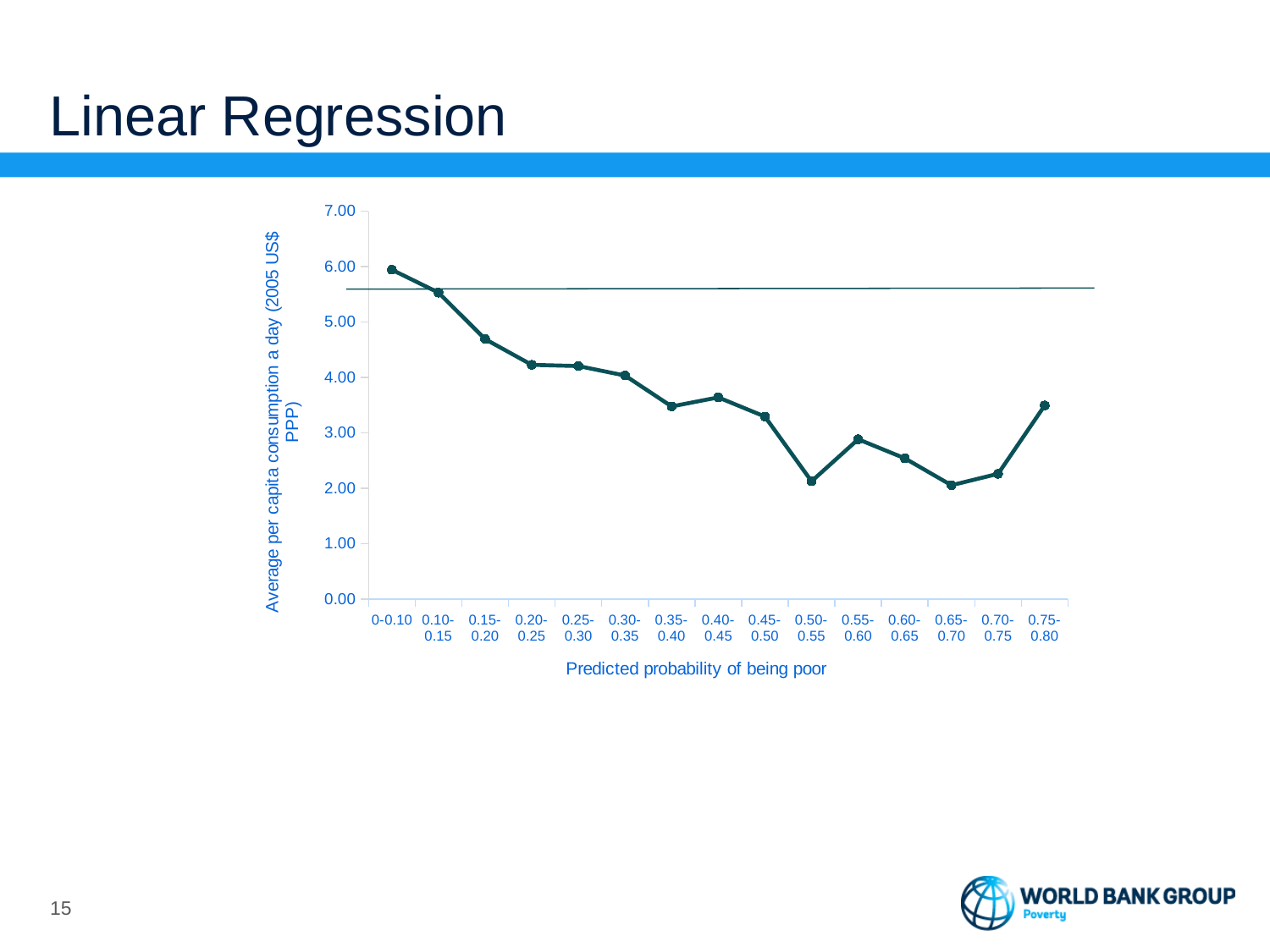
Which predicted probability category has the highest average per capita consumption? 0-0.10 How many predicted probability categories are plotted along the x axis? 15 Is the value for the 0-0.10 category greater or less than 5.00? greater Is the value for the 0.15-0.20 category greater or less than 5.00? less Is the value for the 0.50-0.55 category greater or less than 3.00? less Which has the larger value, the 0.50-0.55 category or the 0.55-0.60 category? 0.55-0.60 Which has the larger value, the 0-0.10 category or the 0.75-0.80 category? 0-0.10 Overall, do the values rise or fall as the predicted probability of being poor increases along the x axis? fall What kind of chart is shown on the slide? line chart What is the title of the x axis? Predicted probability of being poor